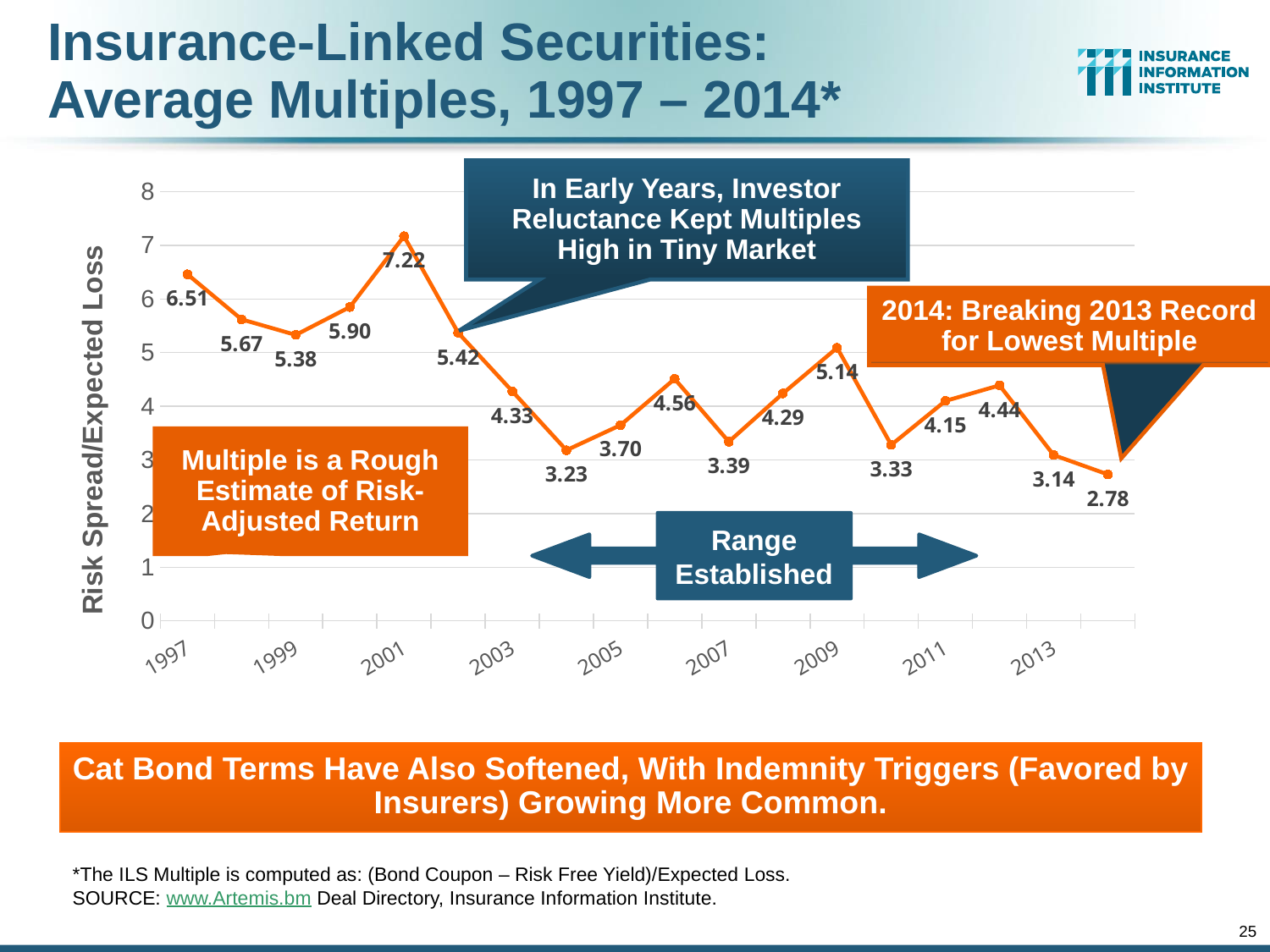
By how much did the average multiple fall from 2013 to 2014? 0.36 What was the average ILS multiple in 2001? 7.22 What was the average ILS multiple in 2009? 5.14 Which year had the lowest average multiple? 2014 Which year had the highest average multiple? 2001 What was the average ILS multiple in 1997? 6.51 What is the label on the vertical axis of the chart? Risk Spread/Expected Loss What type of chart is shown on the slide? line chart What was the average ILS multiple in 2014, the last year plotted? 2.78 Which year had a higher average multiple, 2003 or 2011? 2003 What was the average ILS multiple in 2013? 3.14 Overall, did the average multiple rise or fall from 1997 to 2014? fall